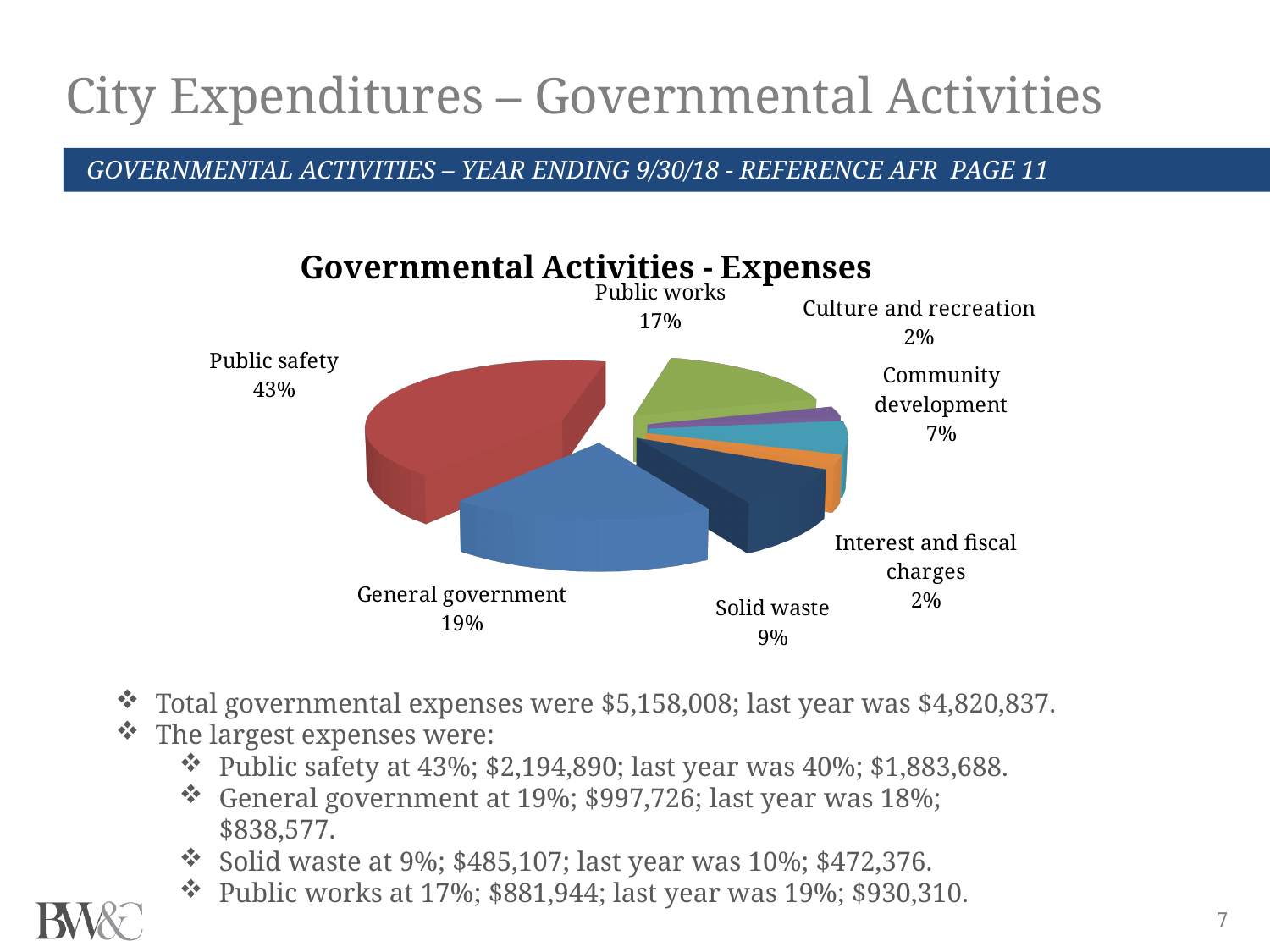
What share of expenses is Public safety? 43% What share of expenses is Public works? 17% What is the difference in percentage points between Public safety and General government? 24 percentage points What is the title of the chart? Governmental Activities - Expenses How many categories are shown in the pie chart? 7 What is the combined share of Culture and recreation and Interest and fiscal charges? 4% What share of expenses is Community development? 7% What type of chart is shown on the slide? Pie chart Which is larger, the share for Public works or the share for Solid waste? Public works Which category has the largest share of expenses? Public safety